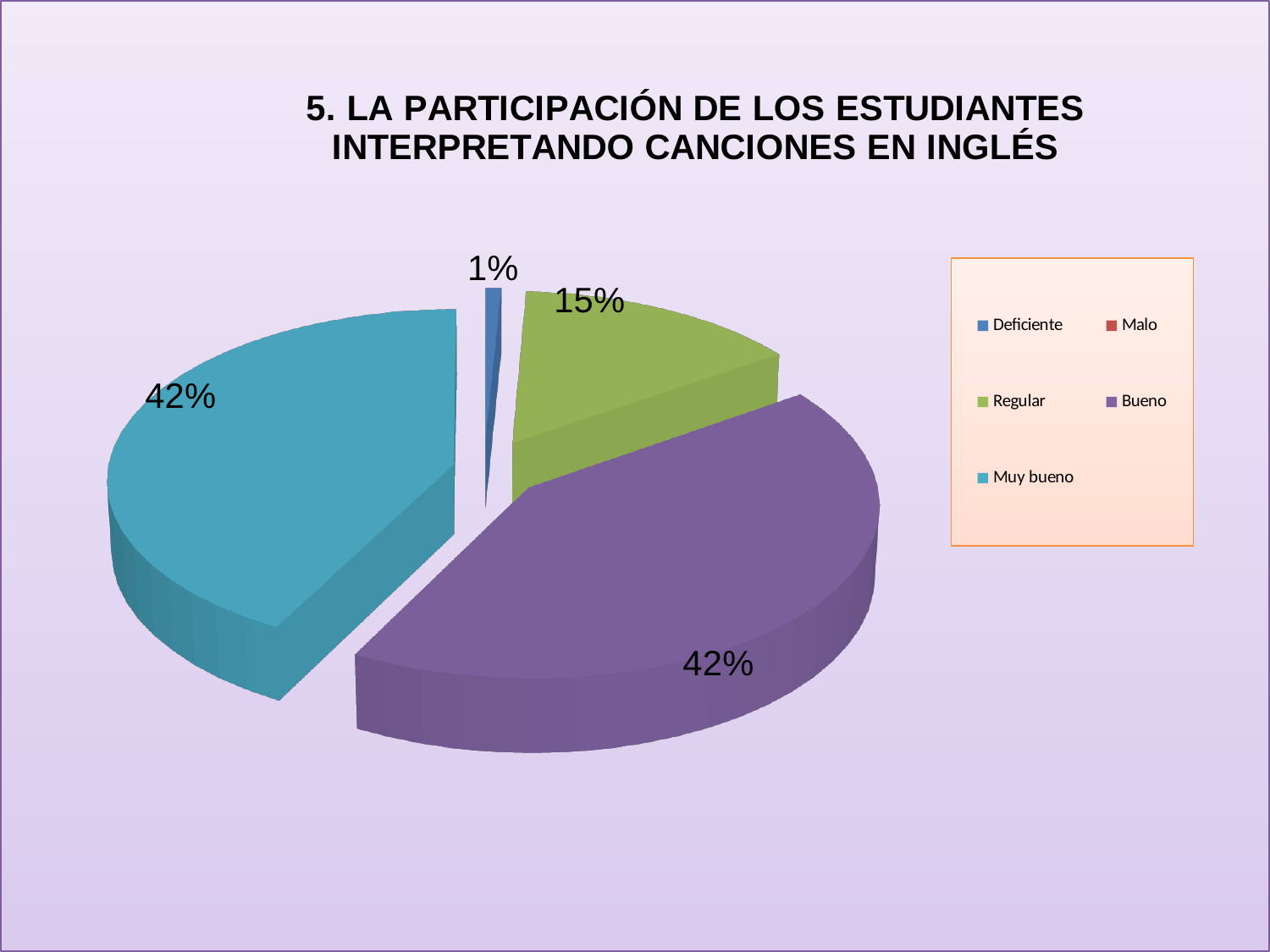
What percentage of the pie is labelled for Deficiente? 1% How many categories are listed in the legend? 5 Which is larger, the share for Regular or the share for Deficiente? Regular Which category has the smallest visible slice of the pie? Deficiente What colour is the Muy bueno slice? teal (blue-green) What is the difference in percentage points between the Regular slice and the Deficiente slice? 14 What percentage of the pie is labelled for Muy bueno? 42% What kind of chart is shown on the slide? pie chart What is the difference in percentage points between the Bueno slice and the Regular slice? 27 What percentage of the pie is labelled for Bueno? 42% What percentage of the pie is labelled for Regular? 15% Which is larger, the share for Bueno or the share for Regular? Bueno